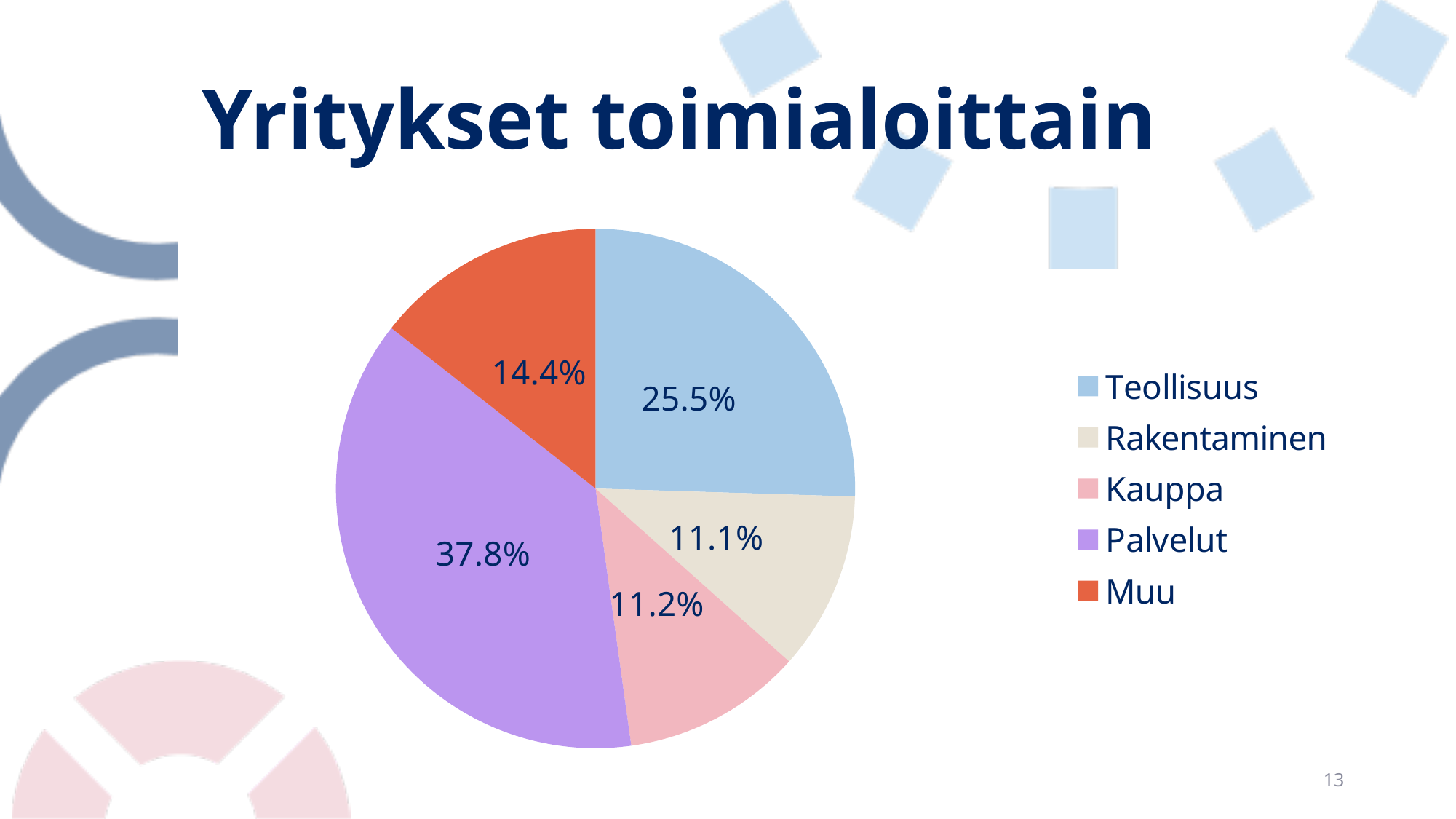
What share of the pie does Palvelut have? 37.8% What share of the pie does Teollisuus have? 25.5% What share of the pie does Rakentaminen have? 11.1% Which has a larger share, Teollisuus or Muu? Teollisuus What is the title of the slide containing the chart? Yritykset toimialoittain What share of the pie does Kauppa have? 11.2% What kind of chart is shown on the slide? Pie chart Which category has the smallest share of the pie? Rakentaminen How many categories are shown in the pie chart? 5 Which category has the largest share of the pie? Palvelut What share of the pie does Muu have? 14.4% What is the difference in percentage points between Palvelut and Teollisuus? 12.3